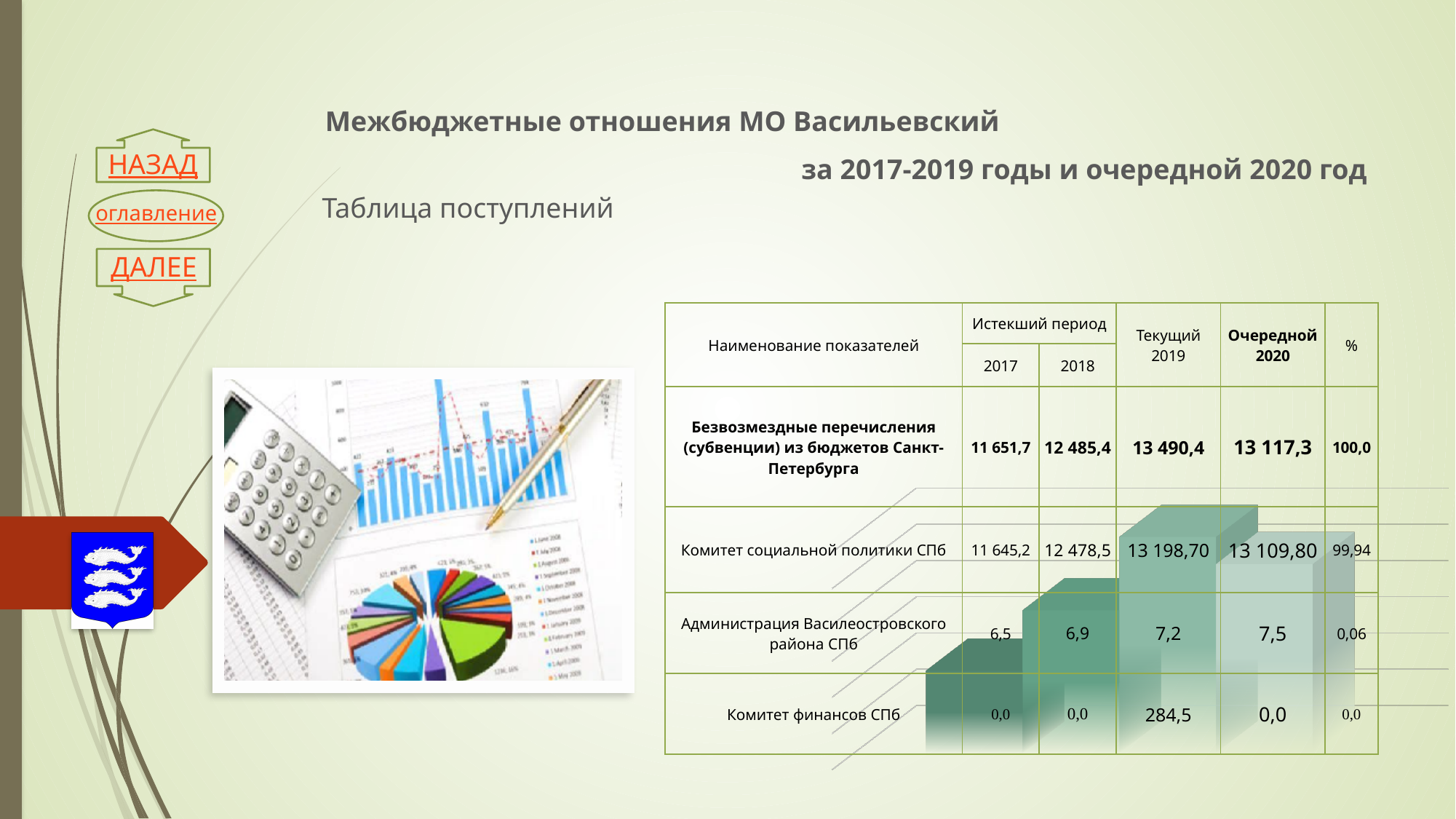
In the chart on the right of the slide, which bar is the shortest: the first, second, third or fourth from the left? first In the chart on the right of the slide, is the second bar from the left taller or shorter than the first bar? taller In the table on the slide, what percentage is shown for 'Комитет социальной политики СПб'? 99,94 In the chart on the right of the slide, which bar is the tallest: the first, second, third or fourth from the left? third What is the title of the slide containing the chart? Межбюджетные отношения МО Васильевский за 2017-2019 годы и очередной 2020 год How many bars does the chart on the right of the slide contain? 4 In the table on the slide, what is the value of 'Безвозмездные перечисления (субвенции) из бюджетов Санкт-Петербурга' for 'Текущий 2019'? 13 490,4 In the table on the slide, what is the value for 'Комитет финансов СПб' in 2019? 284,5 In the table on the slide, what is the value of 'Безвозмездные перечисления (субвенции) из бюджетов Санкт-Петербурга' for 2017? 11 651,7 What kind of chart is shown behind the table on the right of the slide? bar chart In the chart on the right of the slide, do the bars rise or fall from the first bar to the third bar? rise In the table on the slide, what is the value for 'Администрация Василеостровского района СПб' for 'Очередной 2020'? 7,5